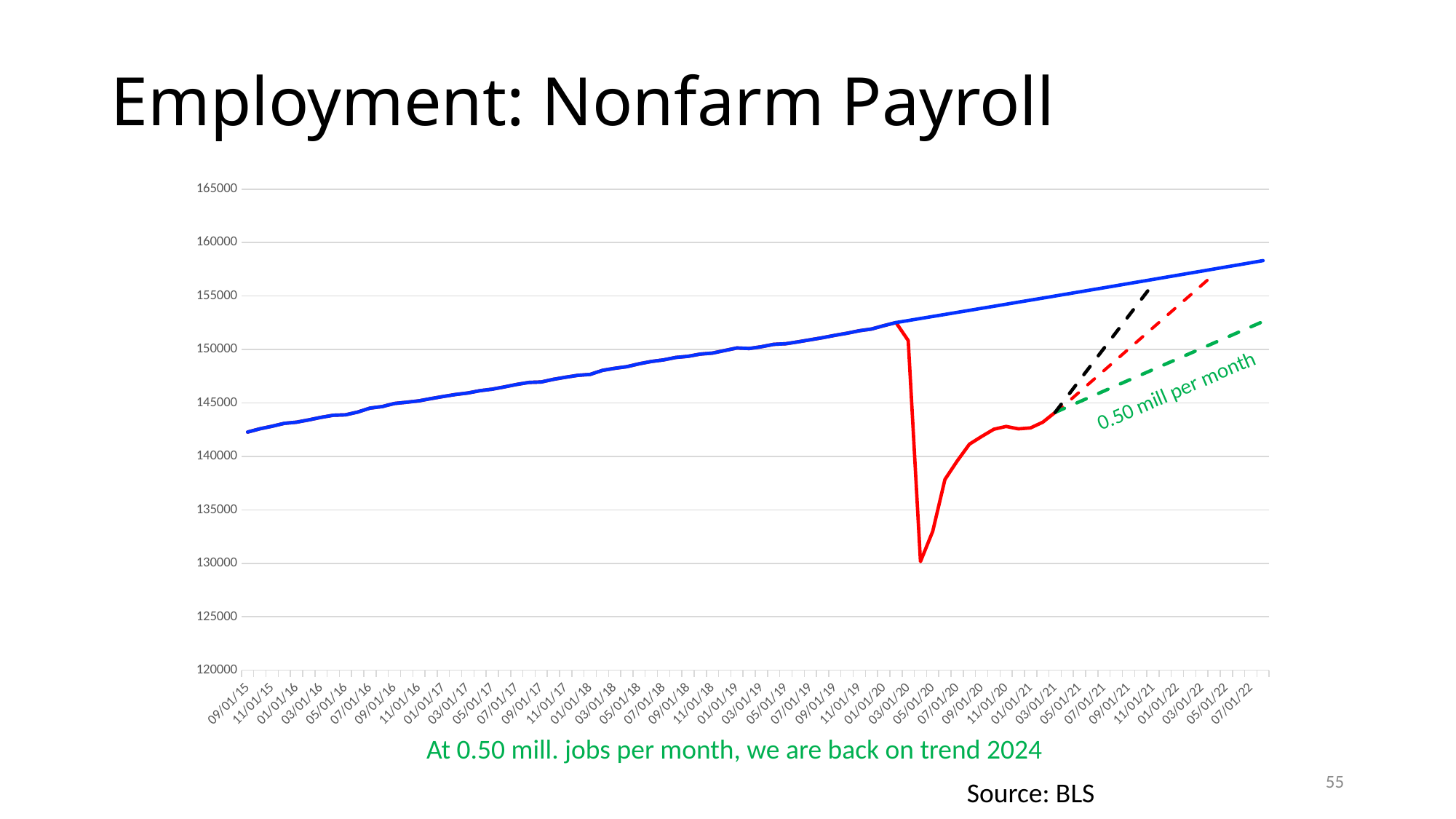
Is the lowest point of the red line greater or less than 135000? less Is the value of the blue line at 07/01/22 greater or less than 155000? greater What kind of chart is shown on the slide? line chart What rate of job growth is labelled next to the green dashed line? 0.50 mill per month What is the title of the slide's chart? Employment: Nonfarm Payroll What is the highest value shown on the vertical axis? 165000 What is the source cited for the chart? BLS Is the value of the blue line at 09/01/15 greater or less than 145000? less How many dashed projection lines extend from the red line? 3 Does the blue line rise or fall from 09/01/15 to 07/01/22? rise Which line is higher at 01/01/21, the blue line or the red line? blue line